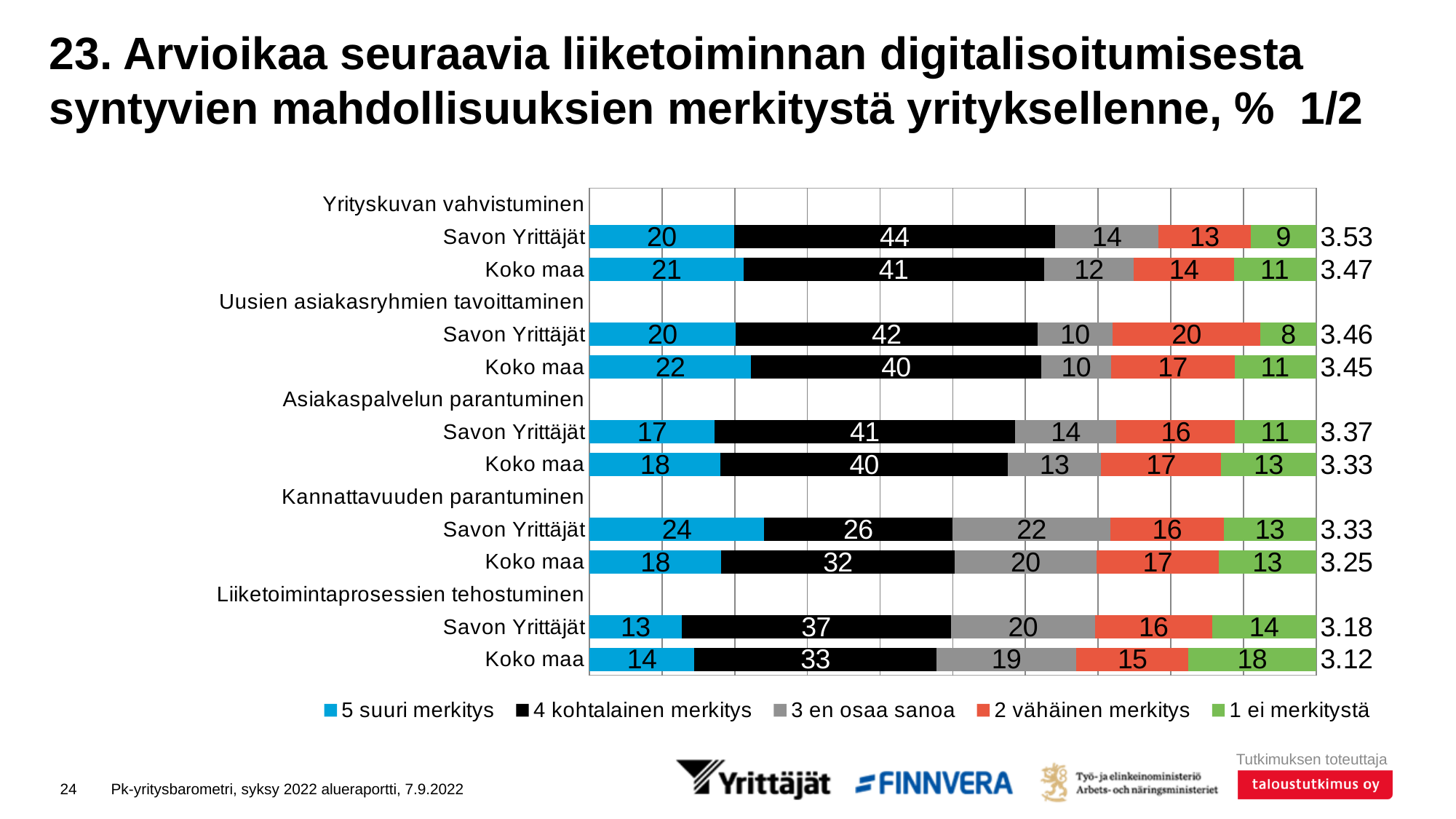
Under Uusien asiakasryhmien tavoittaminen, what is the difference in "2 vähäinen merkitys" between Savon Yrittäjät and Koko maa? 3 What number is printed to the right of the Koko maa bar under Asiakaspalvelun parantuminen? 3.33 How many stacked bars are plotted in the chart? 10 Which bar has the highest value for "5 suuri merkitys"? Savon Yrittäjät, Kannattavuuden parantuminen How many series does the legend list? 5 What is the value of "4 kohtalainen merkitys" for Koko maa under Kannattavuuden parantuminen? 32 Under Kannattavuuden parantuminen, which has the larger "3 en osaa sanoa" value, Savon Yrittäjät or Koko maa? Savon Yrittäjät What is the value of "1 ei merkitystä" for Koko maa under Liiketoimintaprosessien tehostuminen? 18 What is the value of "5 suuri merkitys" for Savon Yrittäjät under Yrityskuvan vahvistuminen? 20 What kind of chart is shown on the slide? Stacked bar chart Which bar has the lowest value for "1 ei merkitystä"? Savon Yrittäjät, Uusien asiakasryhmien tavoittaminen What is the total of the Savon Yrittäjät bar under Yrityskuvan vahvistuminen? 100